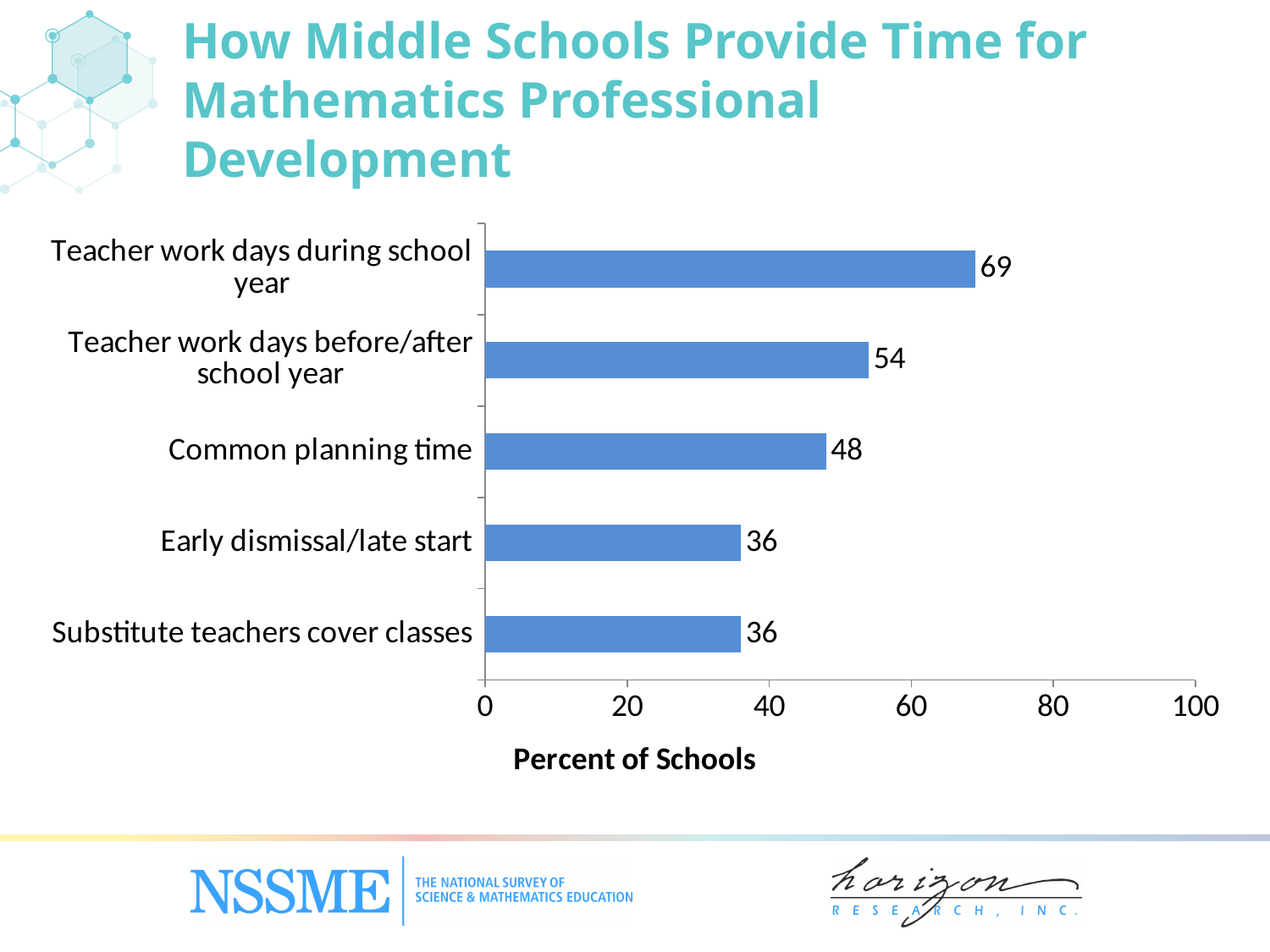
How many categories are shown in the chart? 5 What is the difference between the values for Teacher work days during school year and Common planning time? 21 What is the value for Common planning time? 48 Is the value for Teacher work days during school year greater or less than 60? greater What is the difference between the values for Teacher work days before/after school year and Early dismissal/late start? 18 Which is larger, the value for Common planning time or the value for Early dismissal/late start? Common planning time What kind of chart is shown on the slide? Bar chart What is the value for Teacher work days before/after school year? 54 What is the label of the horizontal axis? Percent of Schools What percent of schools provide time for mathematics professional development through teacher work days during the school year? 69 Which category has the highest percent of schools? Teacher work days during school year What is the value for Substitute teachers cover classes? 36